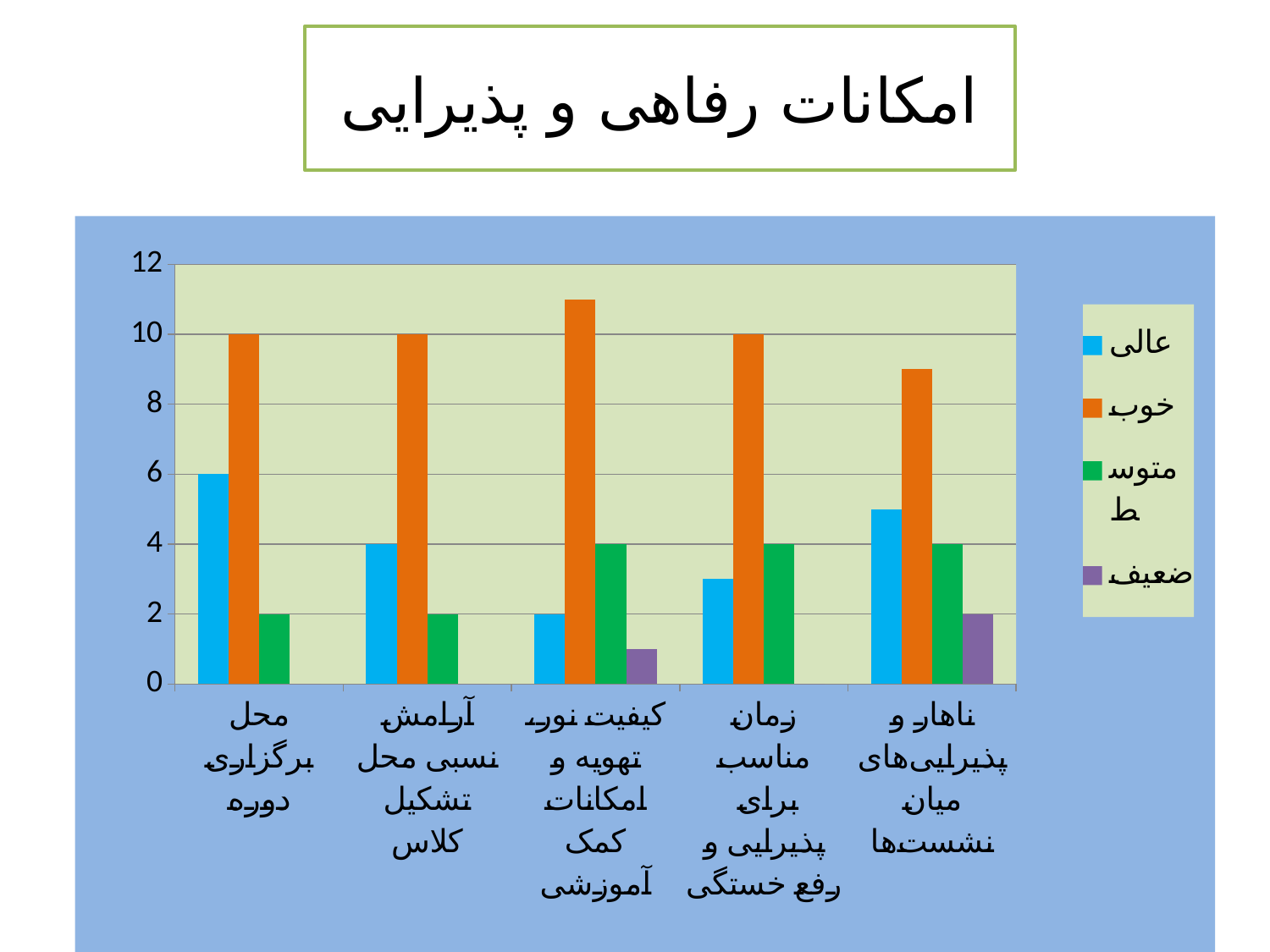
How many categories are shown on the x axis? 5 What kind of chart is shown on the slide? bar chart What is the value of متوسط for زمان مناسب برای پذیرایی و رفع خستگی? 4 What is the difference between the عالی values for محل برگزاری دوره and آرامش نسبی محل تشکیل کلاس? 2 What is the value of خوب for آرامش نسبی محل تشکیل کلاس? 10 How many series does the legend list? 4 What is the value of عالی for کیفیت نور، تهویه و امکانات کمک آموزشی? 2 Which is larger for محل برگزاری دوره: عالی or متوسط? عالی Which category has the highest عالی value? محل برگزاری دوره What is the value of عالی for محل برگزاری دوره? 6 Which category has the highest خوب value? کیفیت نور، تهویه و امکانات کمک آموزشی Is the value of خوب for ناهار و پذیرایی‌های میان نشست‌ها greater or less than 10? less